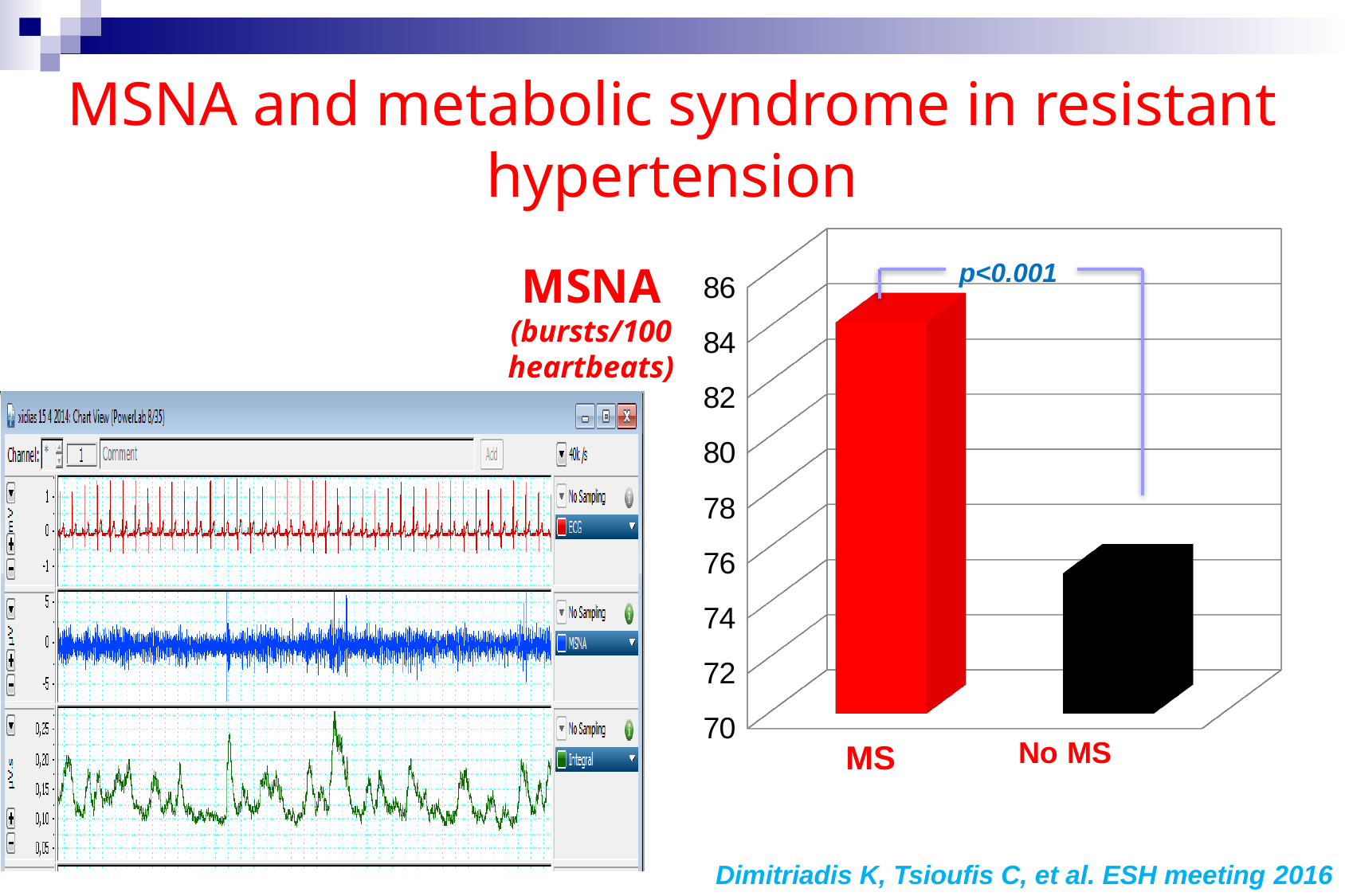
Which category has the lowest MSNA value in the bar chart? No MS What p-value is shown above the bars in the bar chart? p<0.001 Which category has the highest MSNA value in the bar chart? MS Is the value for MS in the bar chart greater or less than 82? greater Is the value for MS in the bar chart greater or less than 86? less Is the value for No MS in the bar chart greater or less than 78? less What unit is MSNA measured in according to the bar chart's axis label? bursts/100 heartbeats In the bar chart, which is larger, the value for MS or the value for No MS? MS How many categories are plotted in the bar chart? 2 What kind of chart is shown on the right side of the slide? bar chart